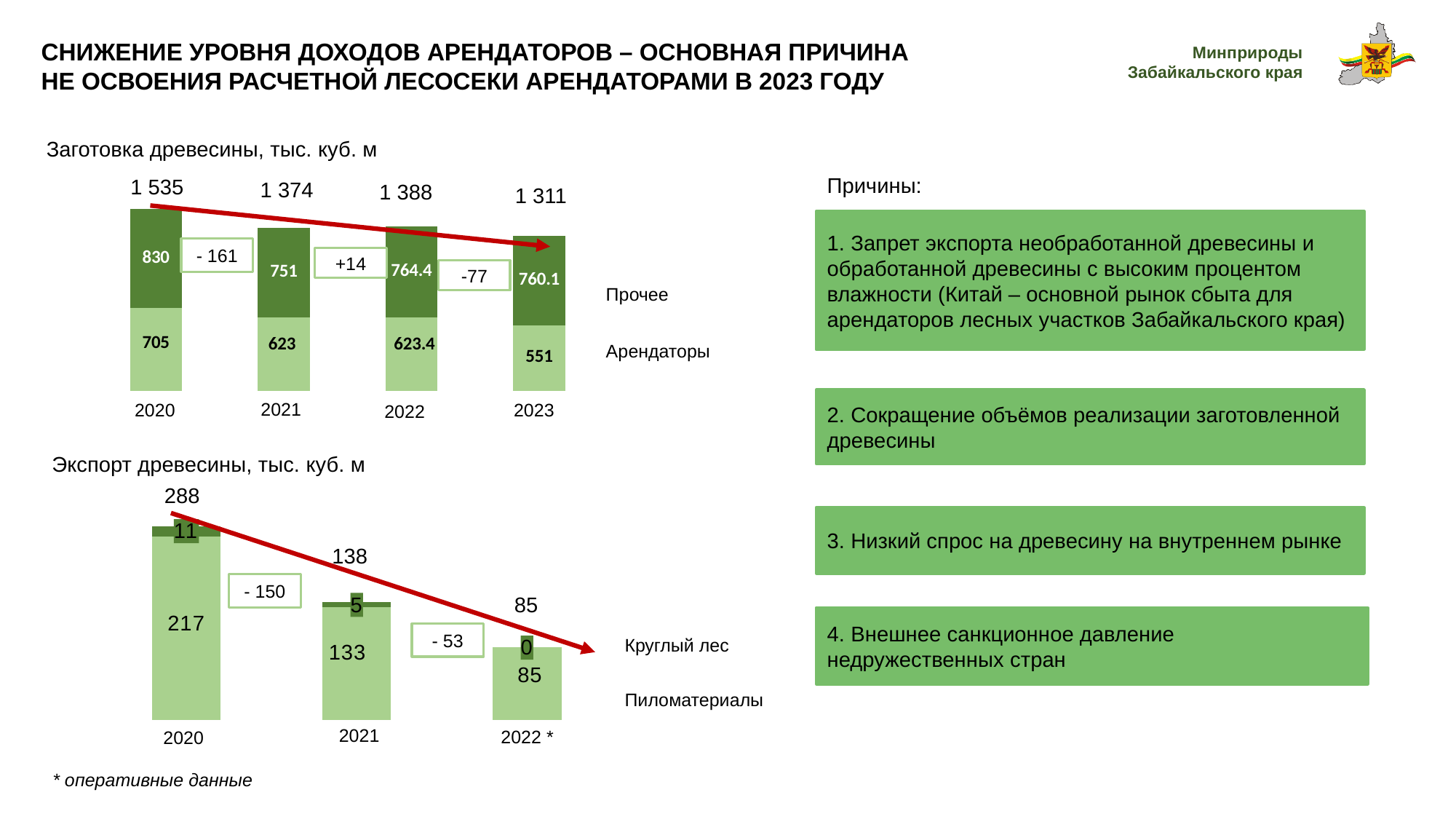
In the 'Заготовка древесины, тыс. куб. м' chart, what is the value for Арендаторы in 2023? 551 In the 'Экспорт древесины, тыс. куб. м' chart, what is the total of the stacked bar for 2020? 288 In the 'Заготовка древесины, тыс. куб. м' chart, which year has the lowest value for Арендаторы? 2023 In the 'Заготовка древесины, тыс. куб. м' chart, what is the total of the stacked bar for 2022? 1 388 In the 'Заготовка древесины, тыс. куб. м' chart, what is the difference between the Арендаторы values for 2020 and 2021? 82 In the 'Заготовка древесины, тыс. куб. м' chart, how many years are shown? 4 What kind of chart is the 'Экспорт древесины, тыс. куб. м' chart? stacked bar chart In the 'Экспорт древесины, тыс. куб. м' chart, what is the value for Пиломатериалы in 2021? 133 In the 'Заготовка древесины, тыс. куб. м' chart, which year has the highest total? 2020 In the 'Экспорт древесины, тыс. куб. м' chart, what is the value for Круглый лес in 2022? 0 In the 'Заготовка древесины, тыс. куб. м' chart, what is the value for Прочее in 2020? 830 In the 'Экспорт древесины, тыс. куб. м' chart, do the totals rise or fall from 2020 to 2022? fall